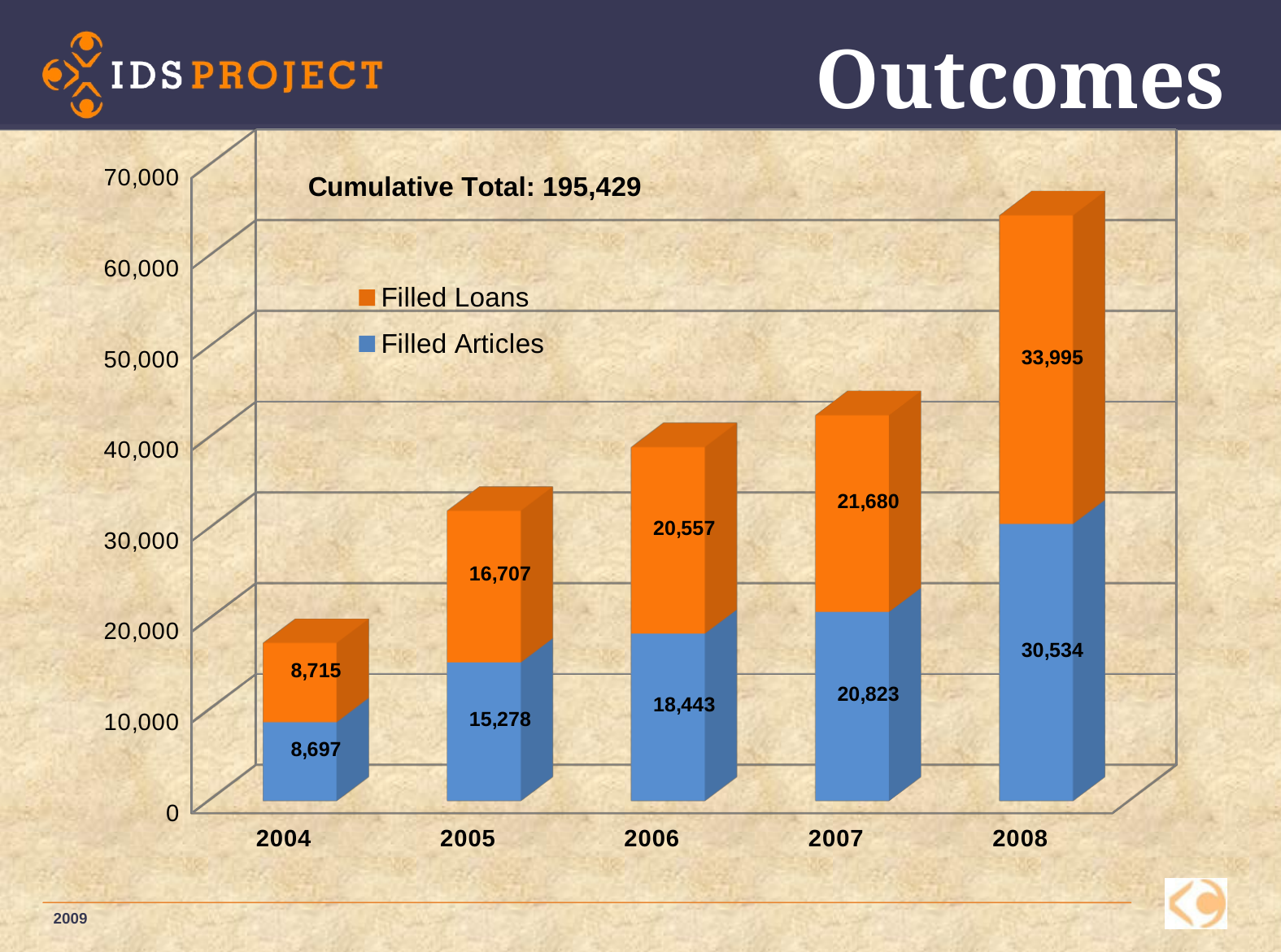
What is the total of the stacked bar for 2008? 64,529 What is the value of Filled Loans for 2008? 33,995 How many years are shown on the x axis? 5 What is the total of the stacked bar for 2004? 17,412 Which year has the lowest value for Filled Articles? 2004 Which year has the highest value for Filled Loans? 2008 How many series does the legend list? 2 What is the difference between Filled Loans and Filled Articles in 2005? 1,429 What is the value of Filled Articles for 2004? 8,697 What is the value of Filled Articles for 2006? 18,443 Which is larger in 2007, Filled Loans or Filled Articles? Filled Loans What kind of chart is shown on the slide? Stacked bar chart